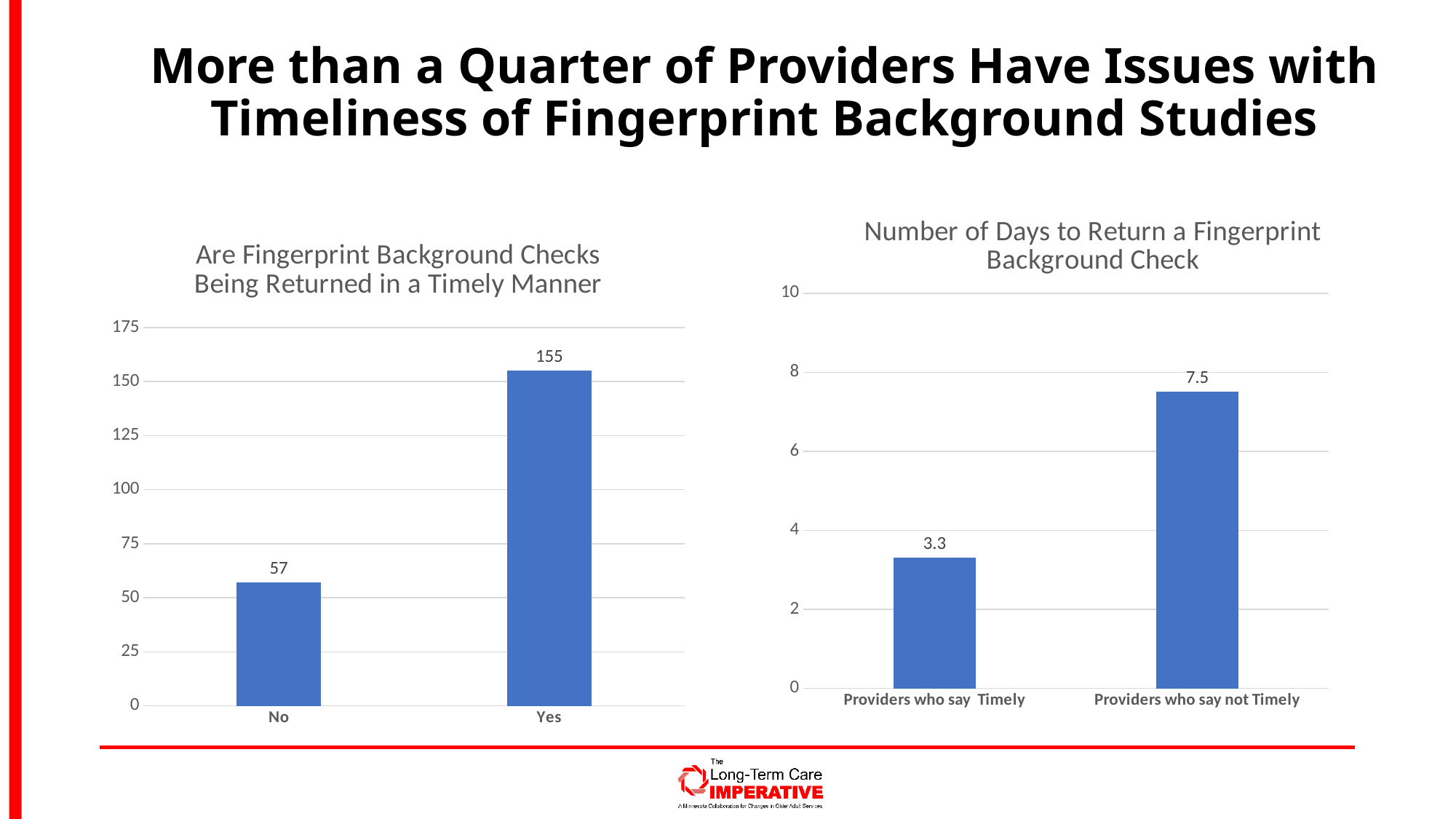
In the chart 'Are Fingerprint Background Checks Being Returned in a Timely Manner', what is the value for 'Yes'? 155 In the chart 'Number of Days to Return a Fingerprint Background Check', what is the value for 'Providers who say not Timely'? 7.5 In the chart 'Number of Days to Return a Fingerprint Background Check', is the value for 'Providers who say not Timely' greater or less than 8? less In the chart 'Are Fingerprint Background Checks Being Returned in a Timely Manner', what is the difference between the 'Yes' and 'No' values? 98 In the chart 'Are Fingerprint Background Checks Being Returned in a Timely Manner', is the value for 'No' greater or less than 75? less In the chart 'Number of Days to Return a Fingerprint Background Check', what is the difference between 'Providers who say not Timely' and 'Providers who say Timely'? 4.2 In the chart 'Are Fingerprint Background Checks Being Returned in a Timely Manner', which category has the highest value? Yes What type of chart is the chart on the right of the slide? Bar chart In the chart 'Number of Days to Return a Fingerprint Background Check', which category has the lowest value? Providers who say Timely In the chart 'Are Fingerprint Background Checks Being Returned in a Timely Manner', how many categories are shown? 2 In the chart 'Number of Days to Return a Fingerprint Background Check', what is the value for 'Providers who say Timely'? 3.3 In the chart 'Are Fingerprint Background Checks Being Returned in a Timely Manner', what is the value for 'No'? 57